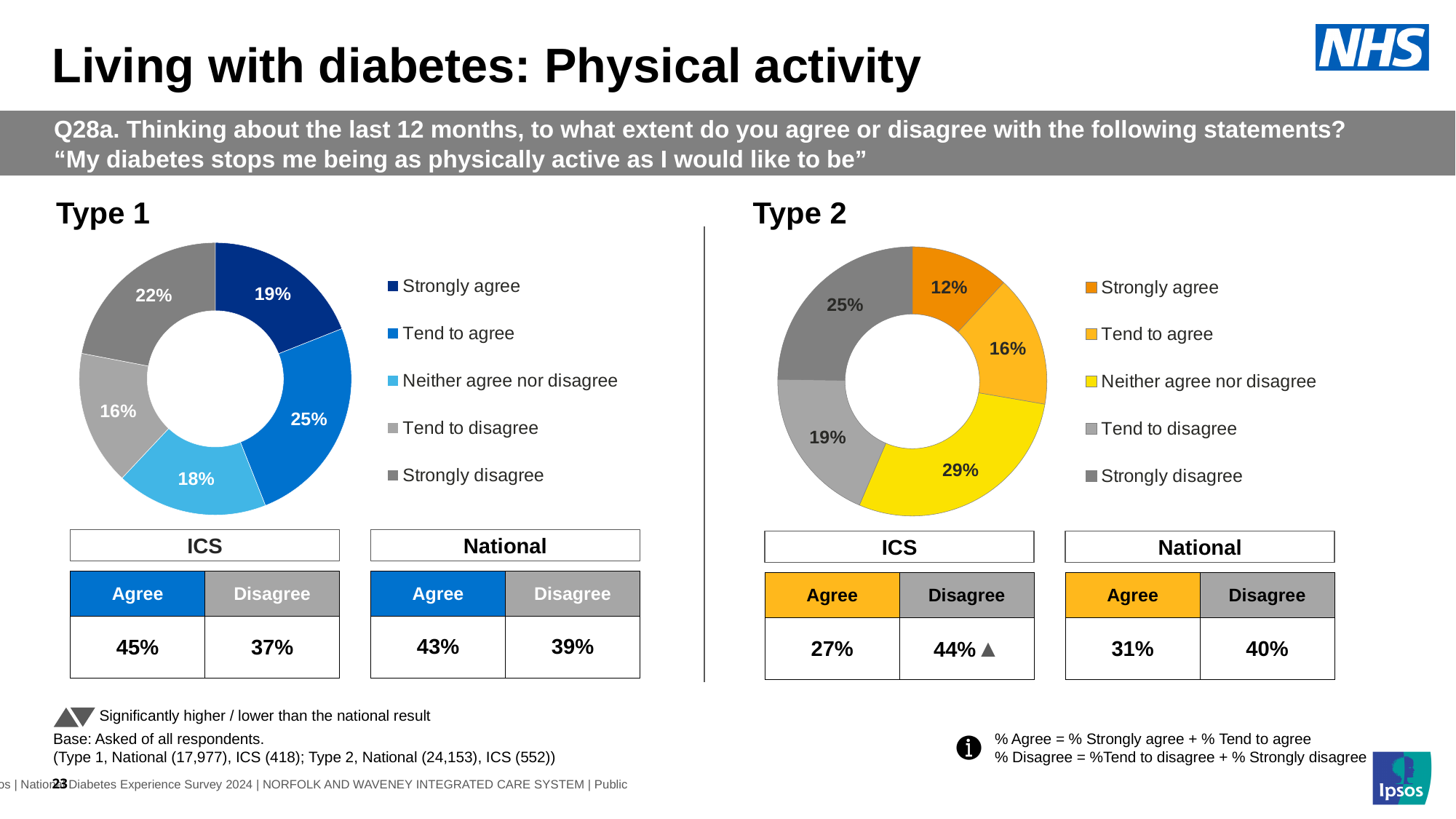
What kind of chart is used to show the Type 2 results? Donut (pie) chart How many response categories does the Type 1 chart's legend list? 5 In the Type 2 chart, what percentage of respondents said 'Neither agree nor disagree'? 29% In the Type 1 chart, what percentage of respondents said 'Strongly disagree'? 22% In the Type 1 chart, what is the difference in percentage points between 'Tend to agree' and 'Tend to disagree'? 9 In the Type 2 chart, what colour is the 'Neither agree nor disagree' segment? Yellow In the Type 1 chart, what percentage of respondents said 'Tend to agree'? 25% In the Type 2 chart, which is larger: 'Strongly disagree' or 'Tend to agree'? Strongly disagree In the Type 1 chart, which response category has the smallest share? Tend to disagree In the Type 2 chart, which response category has the smallest share? Strongly agree In the Type 2 chart, what is the difference in percentage points between 'Strongly disagree' and 'Strongly agree'? 13 In the Type 2 chart, which response category has the largest share? Neither agree nor disagree